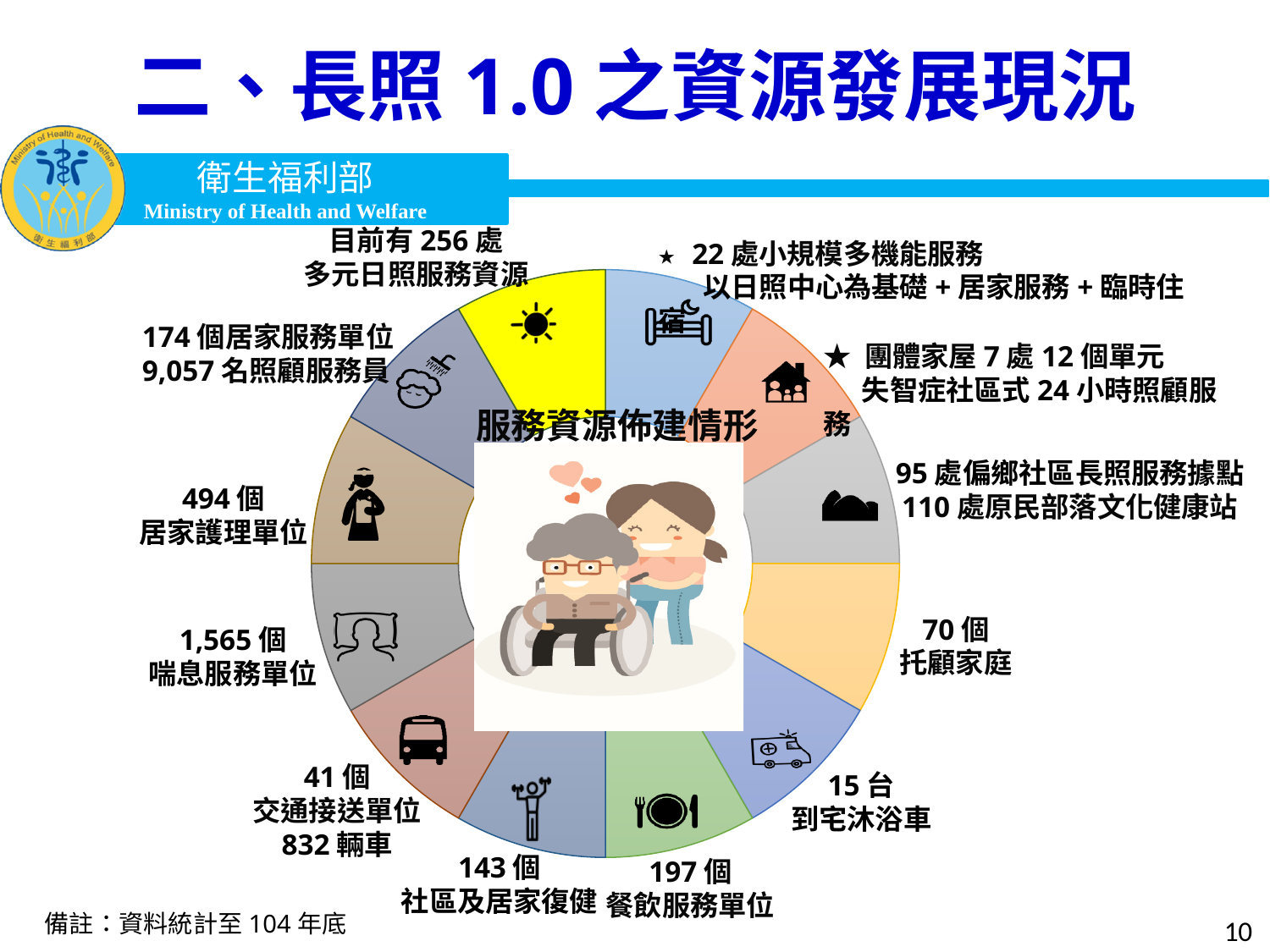
How many 照顧服務員 are listed under 居家服務單位? 9,057 名 How many 輛車 are listed for 交通接送單位? 832 輛車 What is the title shown in the centre of the ring diagram? 服務資源佈建情形 Which has more units: 餐飲服務單位 or 社區及居家復健? 餐飲服務單位 How many 原民部落文化健康站 are there? 110 處 How many 多元日照服務資源 are there according to the slide? 256 處 How many 喘息服務單位 are shown on the slide? 1,565 個 How many segments does the ring diagram have? 12 How many 到宅沐浴車 are listed? 15 台 What kind of chart is shown on the slide? Ring (donut) diagram Which segment label shows the smallest count on the ring diagram? 團體家屋 (7 處) What is the difference between the number of 居家護理單位 (494) and 居家服務單位 (174)? 320